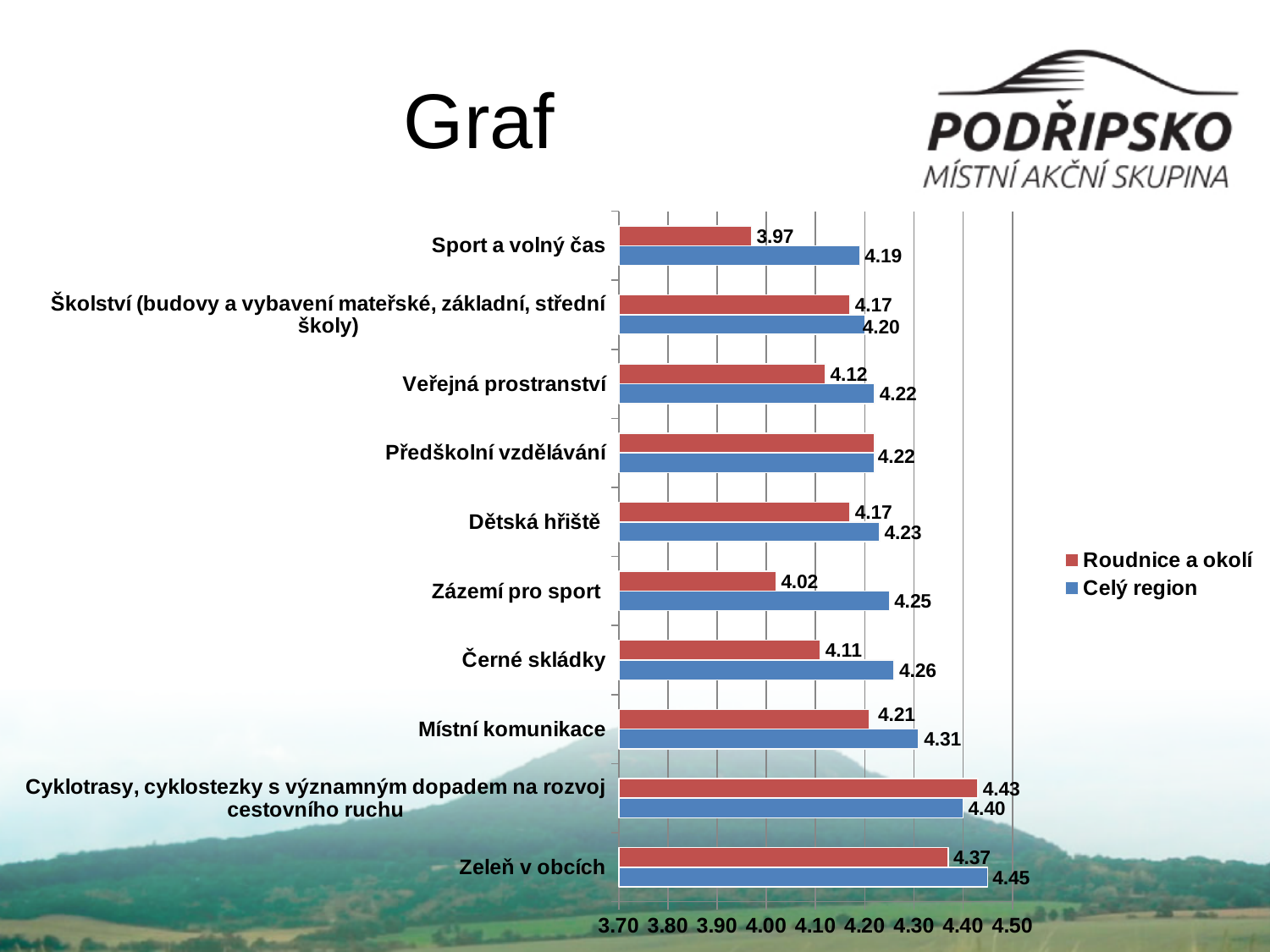
Which category has the lowest value for Roudnice a okolí? Sport a volný čas What kind of chart is shown on the slide? bar chart In the Cyklotrasy, cyklostezky category, which series has the larger value, Roudnice a okolí or Celý region? Roudnice a okolí What is the value for Celý region in the Zeleň v obcích category? 4.45 How many categories are shown on the chart? 10 What is the value for Celý region in the Místní komunikace category? 4.31 Which category has the highest value for Roudnice a okolí? Cyklotrasy, cyklostezky s významným dopadem na rozvoj cestovního ruchu What is the difference between the Celý region and Roudnice a okolí values for Zázemí pro sport? 0.23 What is the value for Roudnice a okolí in the Sport a volný čas category? 3.97 How many series does the legend list? 2 Is the value for Roudnice a okolí in Sport a volný čas greater or less than 4.00? less Which category has the highest value for Celý region? Zeleň v obcích